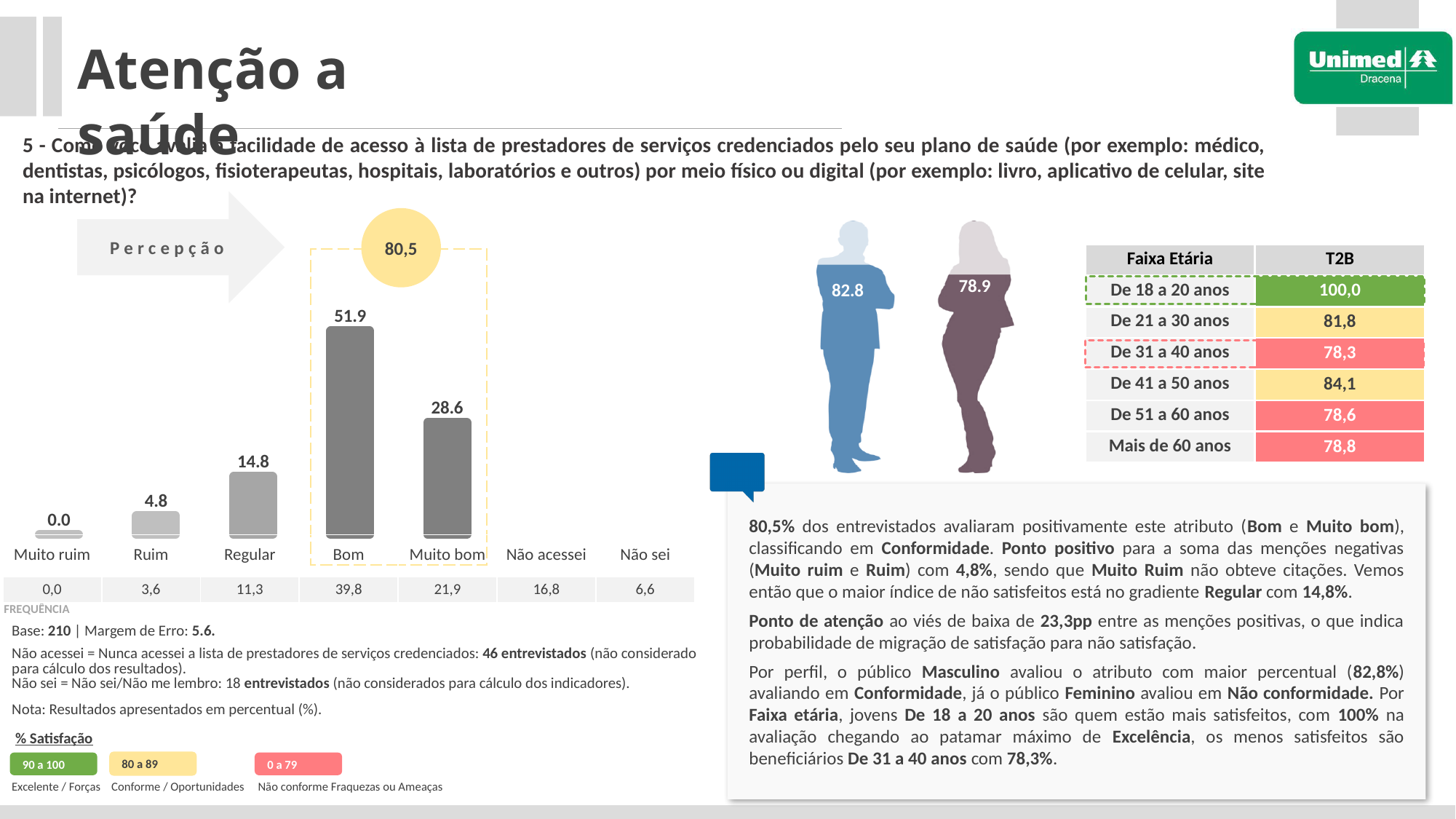
What value is shown in the yellow circle above the 'Bom' and 'Muito bom' bars? 80,5 What is the value shown for the 'Muito bom' bar in the bar chart? 28.6 Which category has the highest bar in the bar chart? Bom Which category has the lowest value in the bar chart? Muito ruim What is the value shown for the 'Bom' bar in the bar chart? 51.9 What is the value shown for the 'Ruim' bar in the bar chart? 4.8 Which is larger in the bar chart, the value for 'Regular' or the value for 'Muito bom'? Muito bom What is the difference between the 'Regular' and 'Ruim' values in the bar chart? 10.0 What is the value shown for the 'Regular' bar in the bar chart? 14.8 What kind of chart is shown on the left of the slide? Bar chart What is the value shown for the 'Muito ruim' bar in the bar chart? 0.0 What is the difference between the 'Bom' and 'Muito bom' values in the bar chart? 23.3